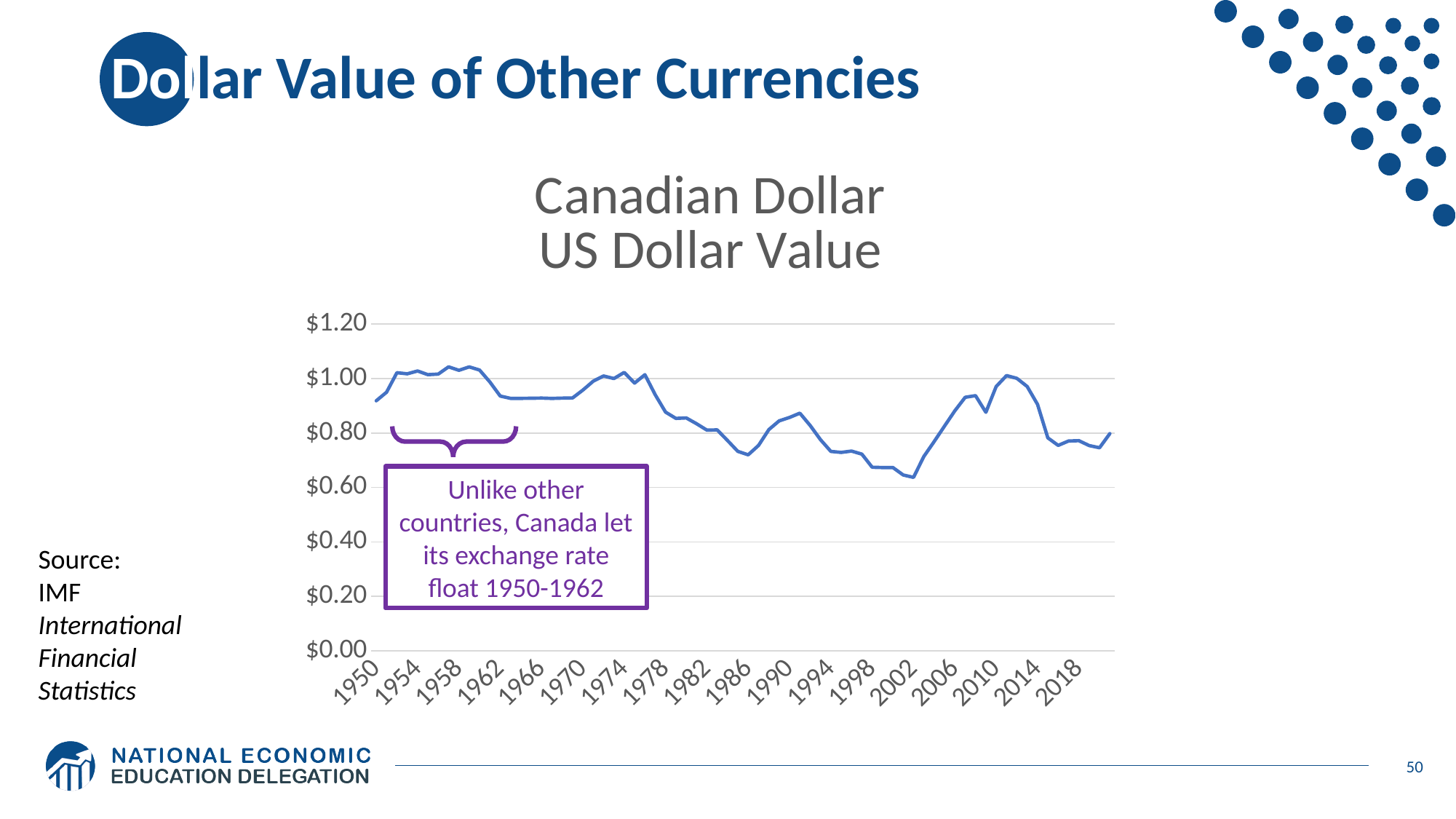
Is the value for 1986 greater or less than $0.80? less Around which year labelled on the x axis does the line reach its lowest point? 2002 Is the value for 1998 greater or less than $0.80? less Is the value for 2010 greater or less than $0.80? greater How many year labels are shown on the x axis? 18 What is the title of the chart? Canadian Dollar US Dollar Value Which is larger, the value for 1974 or the value for 1986? 1974 What kind of chart is shown on the slide? line chart Does the value rise or fall from 1974 to 2002? fall